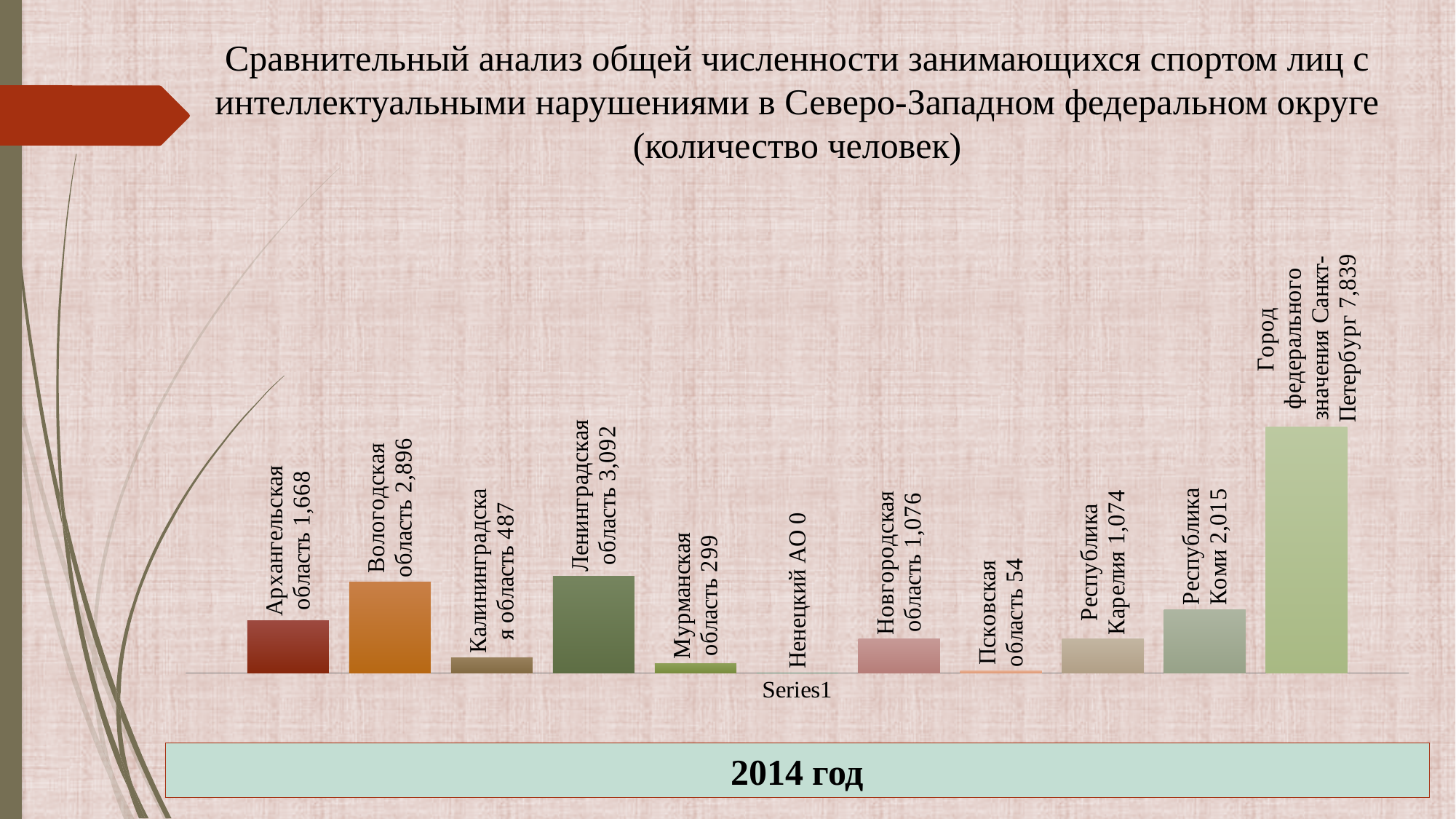
What is the difference between the values for Вологодская область and Архангельская область? 1,228 What kind of chart is shown on the slide? Bar chart What is the value for Республика Коми? 2,015 What is the value for Псковская область? 54 Which region has the lowest value? Ненецкий АО How many regions (bars) are shown in the chart? 11 What is the difference between the values for Санкт-Петербург and Ленинградская область? 4,747 What year does the chart's data refer to, according to the label below the chart? 2014 год Which region has the highest value? Город федерального значения Санкт-Петербург What is the value for Ленинградская область? 3,092 What is the series name shown under the x axis? Series1 Which is larger, the value for Калининградская область or Мурманская область? Калининградская область